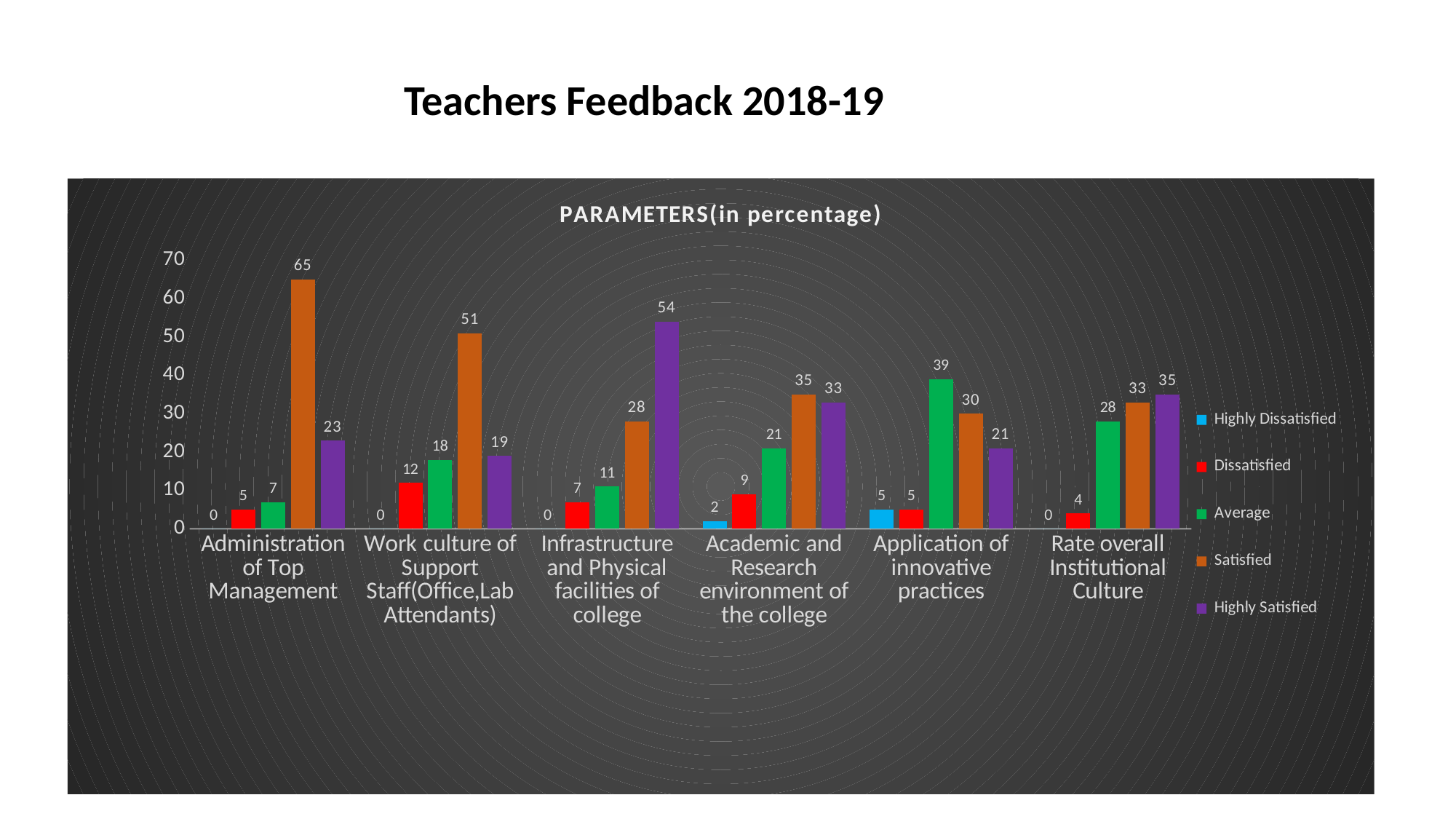
Which is larger for Rate overall Institutional Culture: the Satisfied value or the Highly Satisfied value? Highly Satisfied What kind of chart is shown on the slide? Bar chart How many series does the legend list? 5 What is the Highly Dissatisfied value for Academic and Research environment of the college? 2 How many categories are shown on the x axis? 6 Which category has the highest Satisfied value? Administration of Top Management What is the Satisfied value for Administration of Top Management? 65 What is the difference between the Satisfied and Highly Satisfied values for Work culture of Support Staff(Office,Lab Attendants)? 32 What is the Average value for Application of innovative practices? 39 What is the Highly Satisfied value for Infrastructure and Physical facilities of college? 54 Which category has the lowest Highly Satisfied value? Work culture of Support Staff(Office,Lab Attendants) What is the title of the chart? PARAMETERS(in percentage)